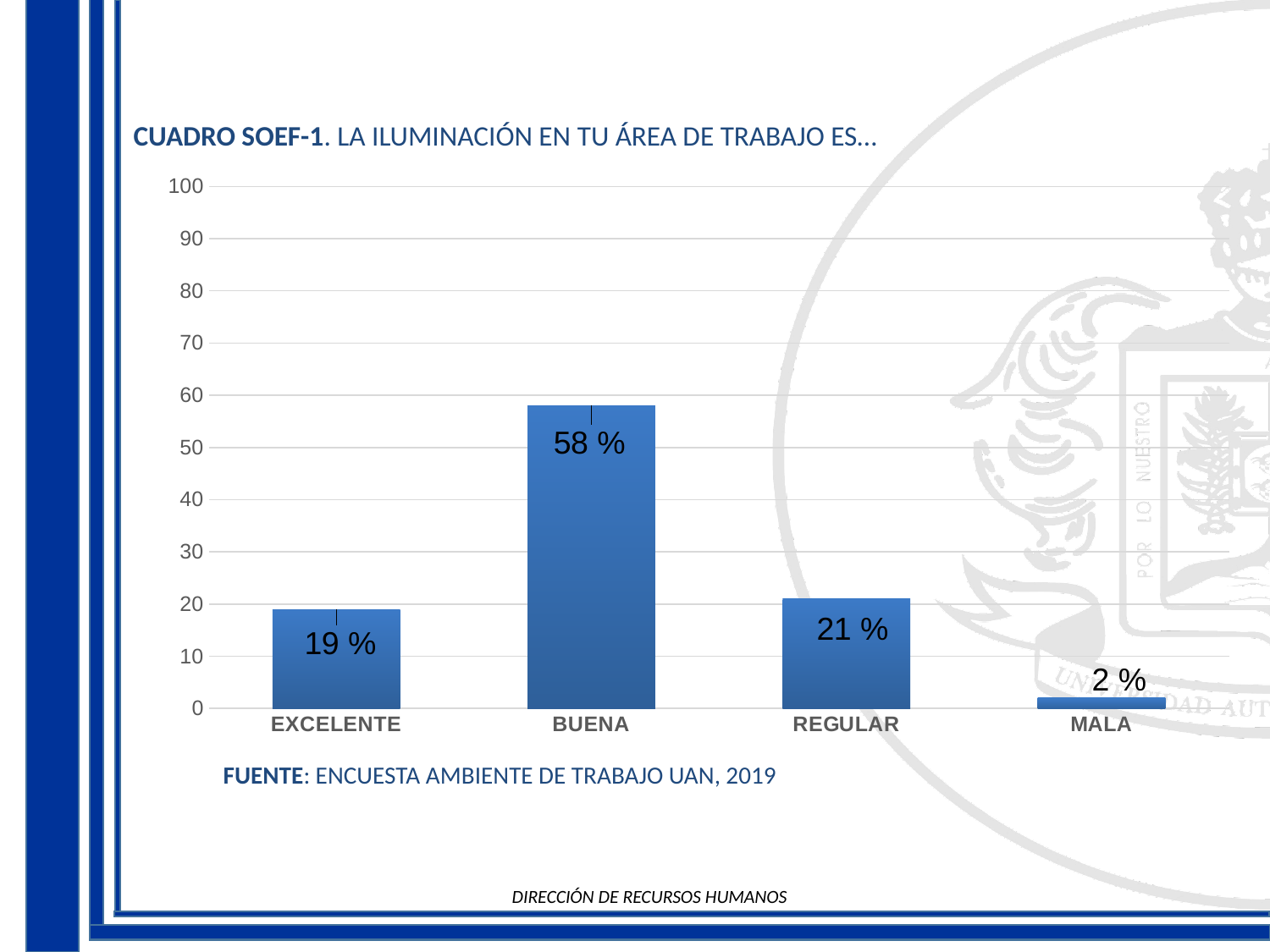
Is the value for BUENA greater or less than 50? greater What is the value for EXCELENTE? 19 % What is the source cited below the chart? ENCUESTA AMBIENTE DE TRABAJO UAN, 2019 What kind of chart is shown on the slide? bar chart Which category has the highest value? BUENA What is the value for MALA? 2 % What is the value for REGULAR? 21 % How many categories are shown on the x axis? 4 Which is larger, the value for REGULAR or the value for EXCELENTE? REGULAR What is the difference between the values for BUENA and REGULAR? 37 % What is the value for BUENA? 58 % Which category has the lowest value? MALA